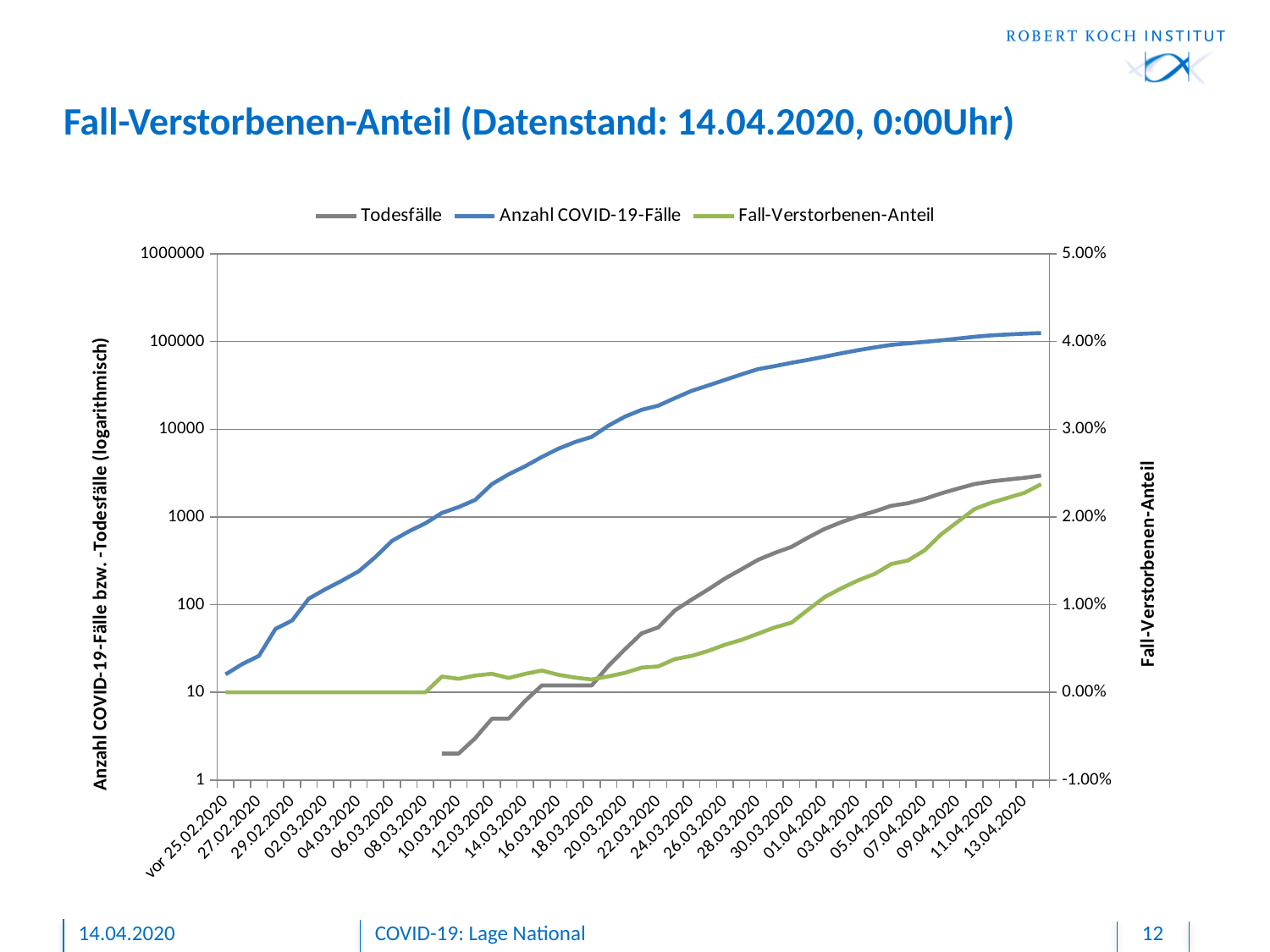
Is the Fall-Verstorbenen-Anteil on 13.04.2020 greater or less than 2.00%? greater What kind of chart is shown on the slide? line chart Is the value of Anzahl COVID-19-Fälle on 26.03.2020 greater or less than 10000? greater Does the Todesfälle line rise or fall from 10.03.2020 to 13.04.2020? rise Does the Anzahl COVID-19-Fälle line rise or fall from left to right along the x axis? rise What is the label of the right-hand vertical axis? Fall-Verstorbenen-Anteil How many series does the legend list? 3 Is the value of Anzahl COVID-19-Fälle on 06.03.2020 greater or less than 1000? less What is the title of the chart? Fall-Verstorbenen-Anteil (Datenstand: 14.04.2020, 0:00Uhr) On 13.04.2020, which is larger: Todesfälle or Anzahl COVID-19-Fälle? Anzahl COVID-19-Fälle